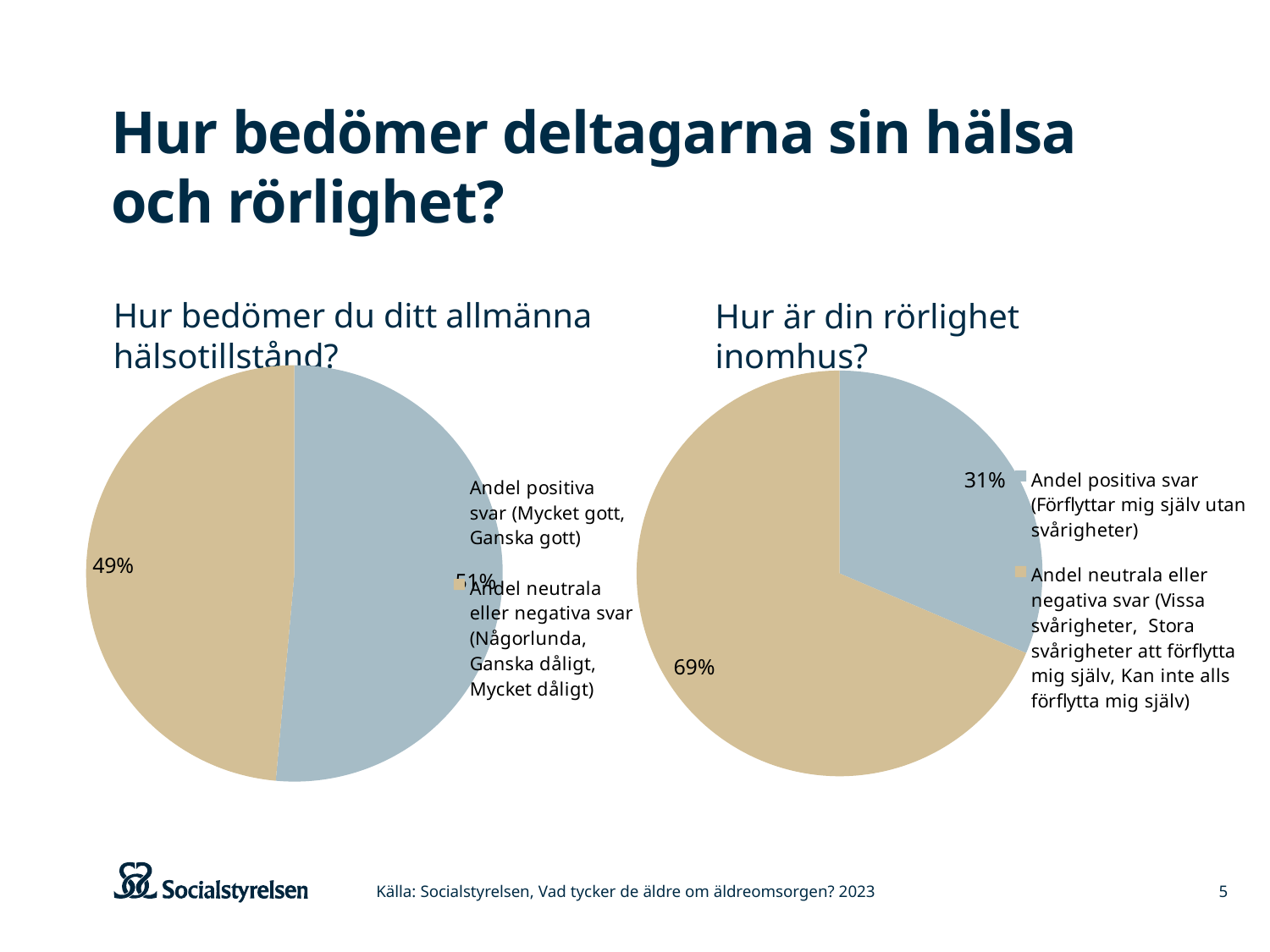
In the chart 'Hur är din rörlighet inomhus?', which category has the smallest share? Andel positiva svar In the chart 'Hur är din rörlighet inomhus?', is the share of positive answers larger or smaller than the share of neutral or negative answers? Smaller In the chart 'Hur är din rörlighet inomhus?', what colour is the slice for 'Andel positiva svar'? Blue How many categories does the legend of the chart 'Hur bedömer du ditt allmänna hälsotillstånd?' list? 2 In the chart 'Hur är din rörlighet inomhus?', what share is 'Andel positiva svar'? 31% In the chart 'Hur är din rörlighet inomhus?', what share is 'Andel neutrala eller negativa svar'? 69% In the chart 'Hur bedömer du ditt allmänna hälsotillstånd?', what share is 'Andel neutrala eller negativa svar'? 49% What kind of chart is used for 'Hur bedömer du ditt allmänna hälsotillstånd?'? Pie chart In the chart 'Hur är din rörlighet inomhus?', which category has the largest share? Andel neutrala eller negativa svar How many pie charts are shown on the slide? 2 In the chart 'Hur är din rörlighet inomhus?', what is the difference between the neutral/negative share and the positive share? 38 percentage points How many slices does the pie chart 'Hur är din rörlighet inomhus?' have? 2